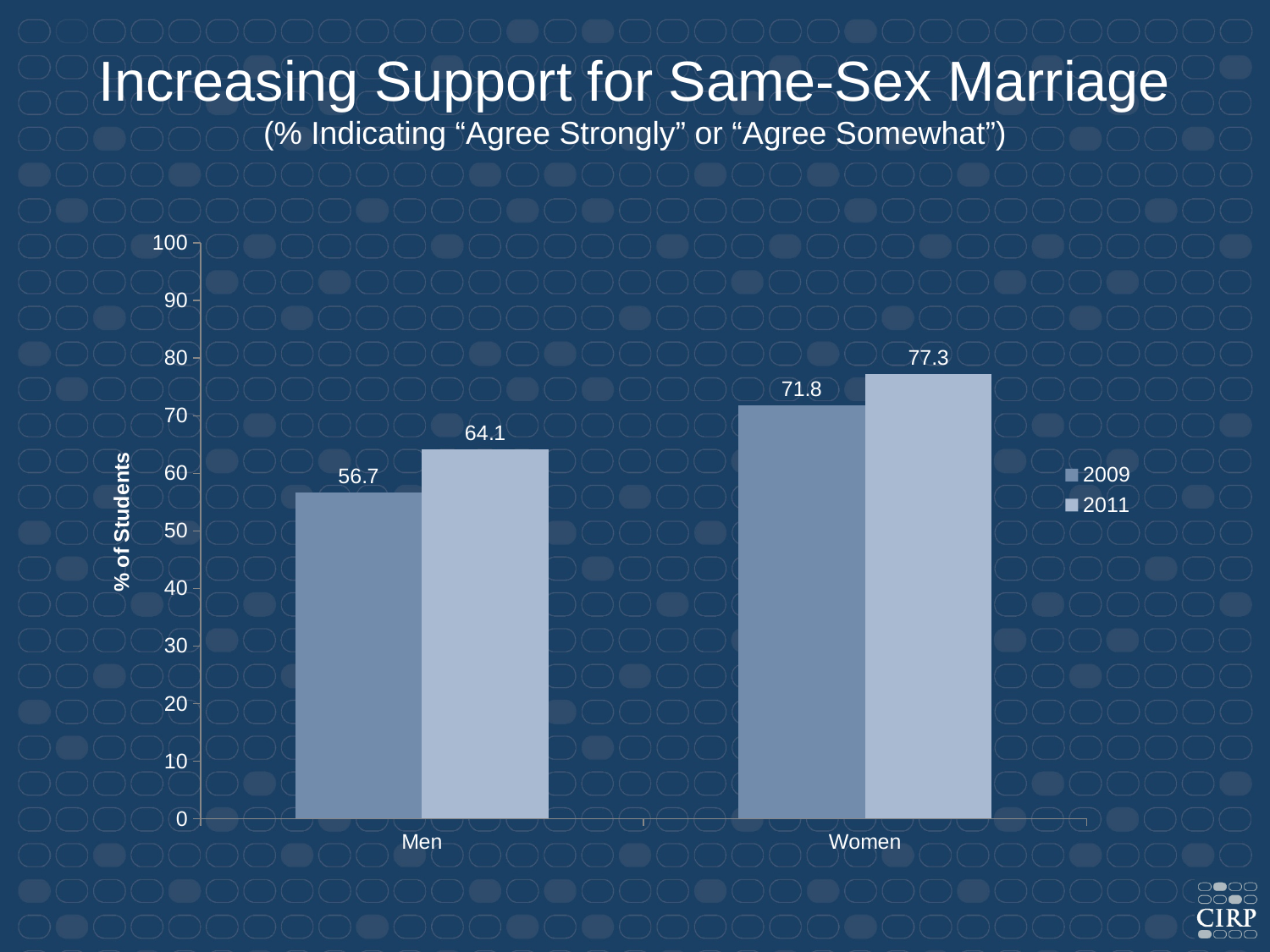
What is the difference between the 2011 and 2009 values for Men? 7.4 What is the value for Men in 2011? 64.1 What is the value for Men in 2009? 56.7 What is the difference between the 2011 and 2009 values for Women? 5.5 What kind of chart is shown on the slide? Bar chart Which is larger: the 2009 value for Women or the 2011 value for Men? 2009 value for Women Which group has the highest value in 2011? Women What is the value for Women in 2011? 77.3 How many categories are shown on the x axis? 2 Which bar has the lowest value on the chart? Men, 2009 What is the label of the y axis? % of Students How many series does the legend list? 2